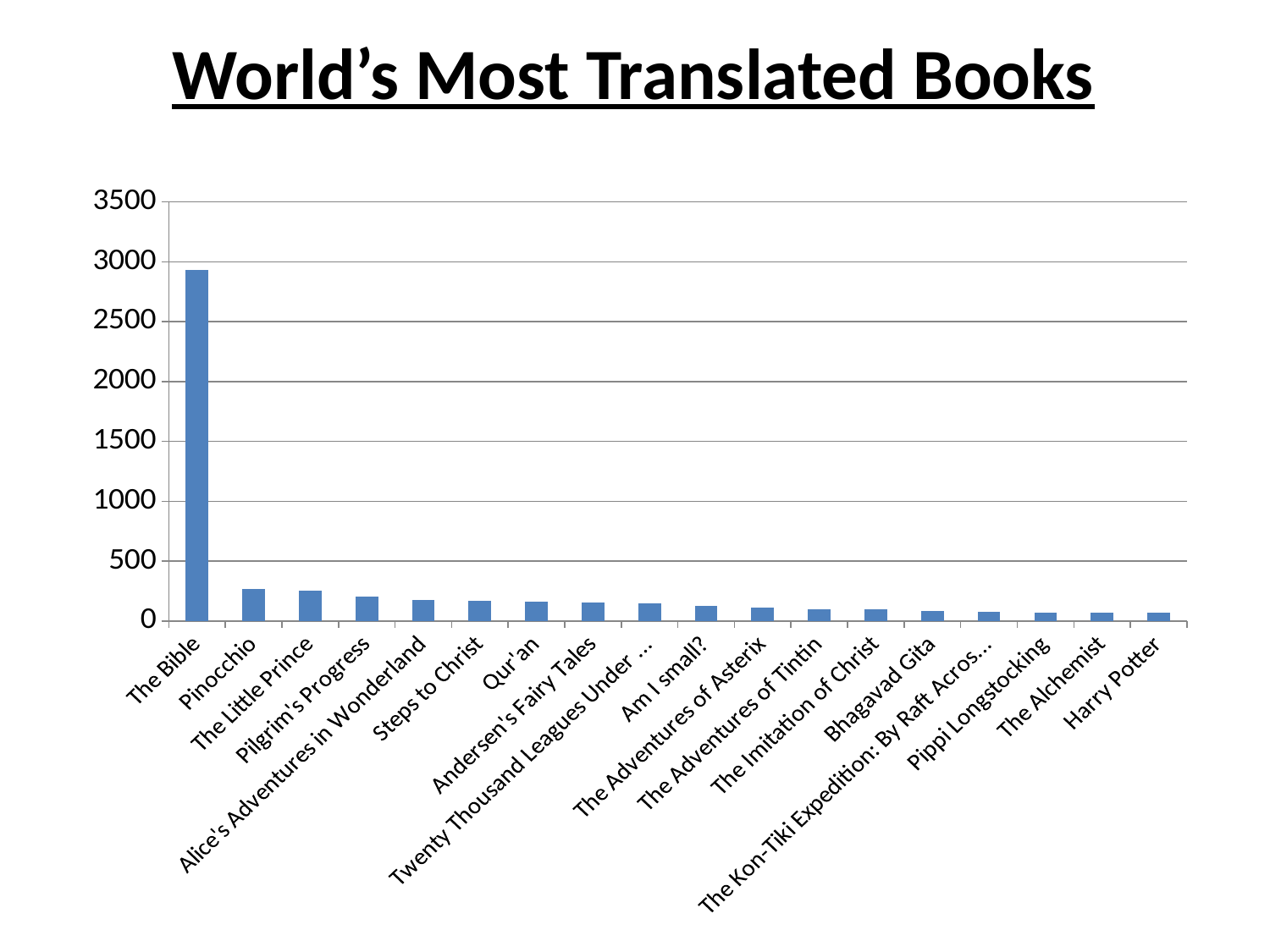
What kind of chart is shown on the slide? bar chart Which book has the highest value in the chart? The Bible Which has a larger value, The Bible or Pinocchio? The Bible Is the value for The Bible greater or less than 2500? greater Which has a larger value, Pinocchio or Harry Potter? Pinocchio Is the value for The Bible greater or less than 3000? less Do the values generally rise or fall moving from left to right along the x axis? fall What colour are the bars in the chart? blue How many books are shown on the x axis of the chart? 18 Is the value for Pinocchio greater or less than 500? less What is the title of the chart? World's Most Translated Books